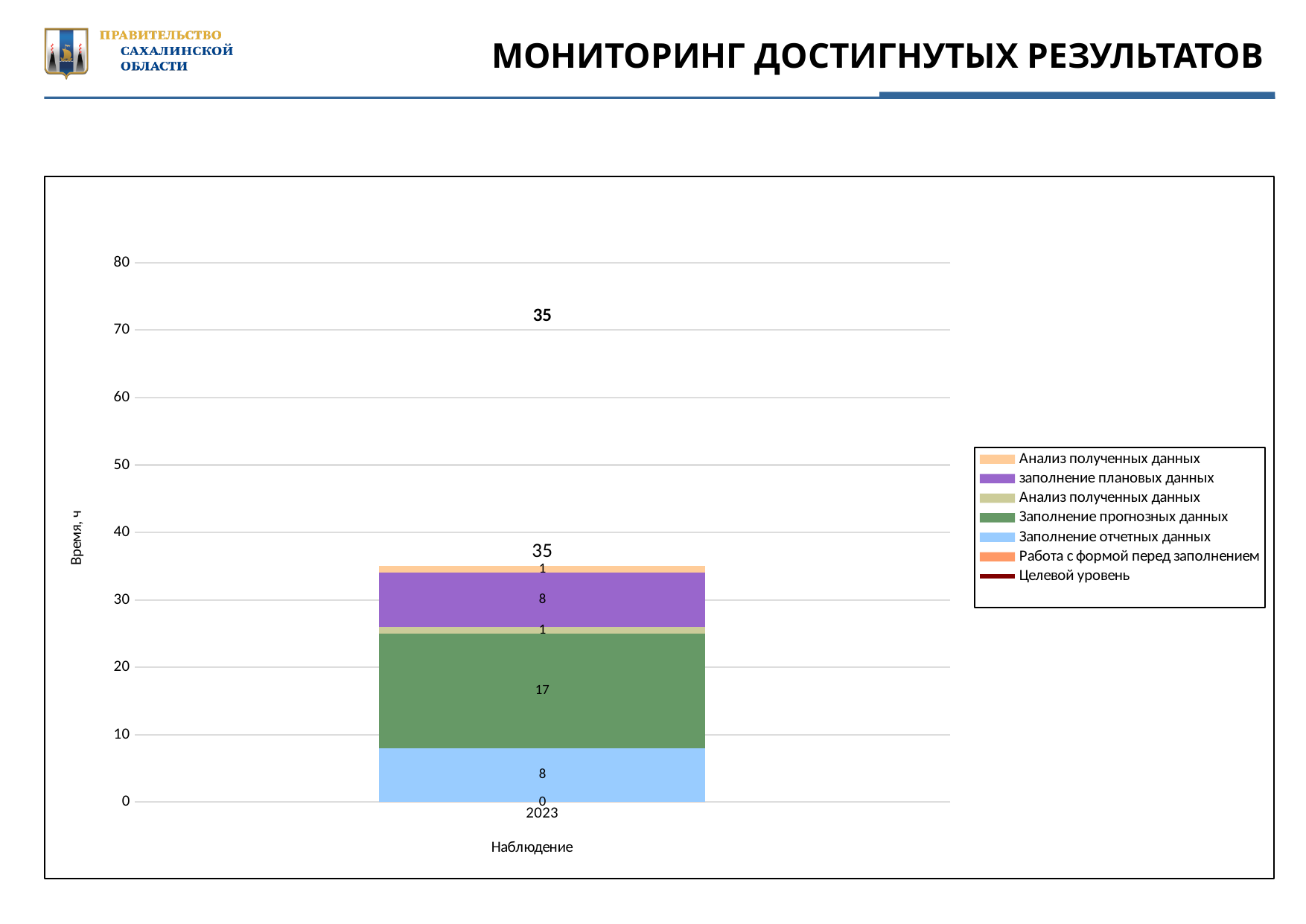
What is the value of the 'Заполнение прогнозных данных' segment for 2023? 17 What is the total of the stacked bar for 2023? 35 Which is larger for 2023: 'Заполнение прогнозных данных' or 'заполнение плановых данных'? Заполнение прогнозных данных What type of chart is shown on the slide? stacked bar chart What is the difference between the 'Заполнение прогнозных данных' and 'Заполнение отчетных данных' segments for 2023? 9 How many categories are shown on the x axis of the chart? 1 What is the value of the 'Работа с формой перед заполнением' segment for 2023? 0 Which segment of the 2023 bar has the largest value? Заполнение прогнозных данных What is the value of the 'заполнение плановых данных' segment for 2023? 8 How many series does the chart legend list? 7 What is the value of the 'Заполнение отчетных данных' segment for 2023? 8 What is the label of the y axis of the chart? Время, ч